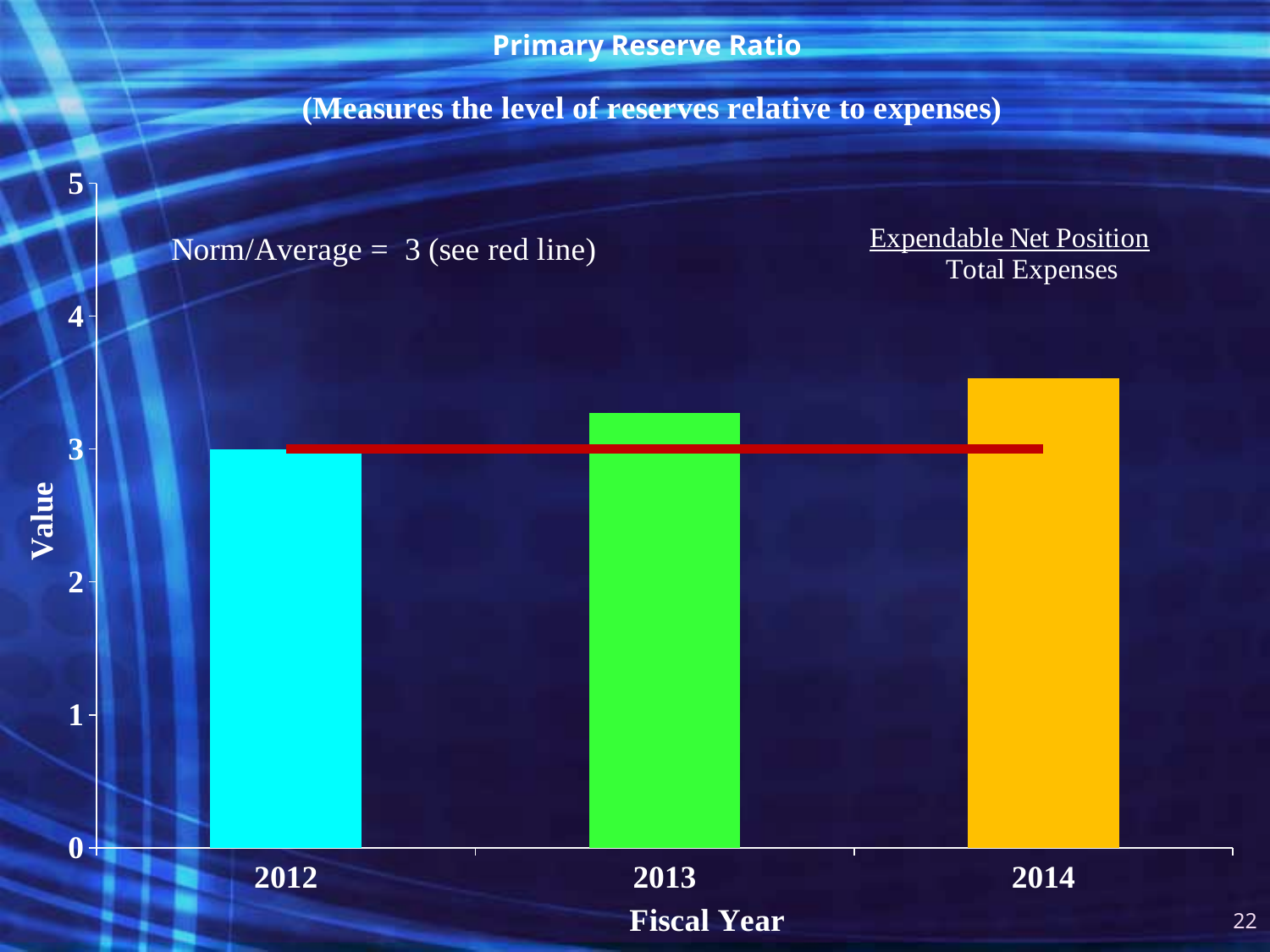
What is the title of the chart? Primary Reserve Ratio Which fiscal year has the highest Primary Reserve Ratio? 2014 How many fiscal years are plotted in the chart? 3 Is the value for 2013 greater or less than 4? less Is the value for 2014 greater or less than 3? greater Is the value for 2012 greater or less than 4? less What value does the red line on the chart represent? Norm/Average = 3 Which fiscal year has the lowest Primary Reserve Ratio? 2012 What kind of chart is shown on the slide? bar chart with a line (combination bar and line chart) Do the values rise or fall from 2012 to 2014? rise Which is larger, the value for 2013 or the value for 2014? 2014